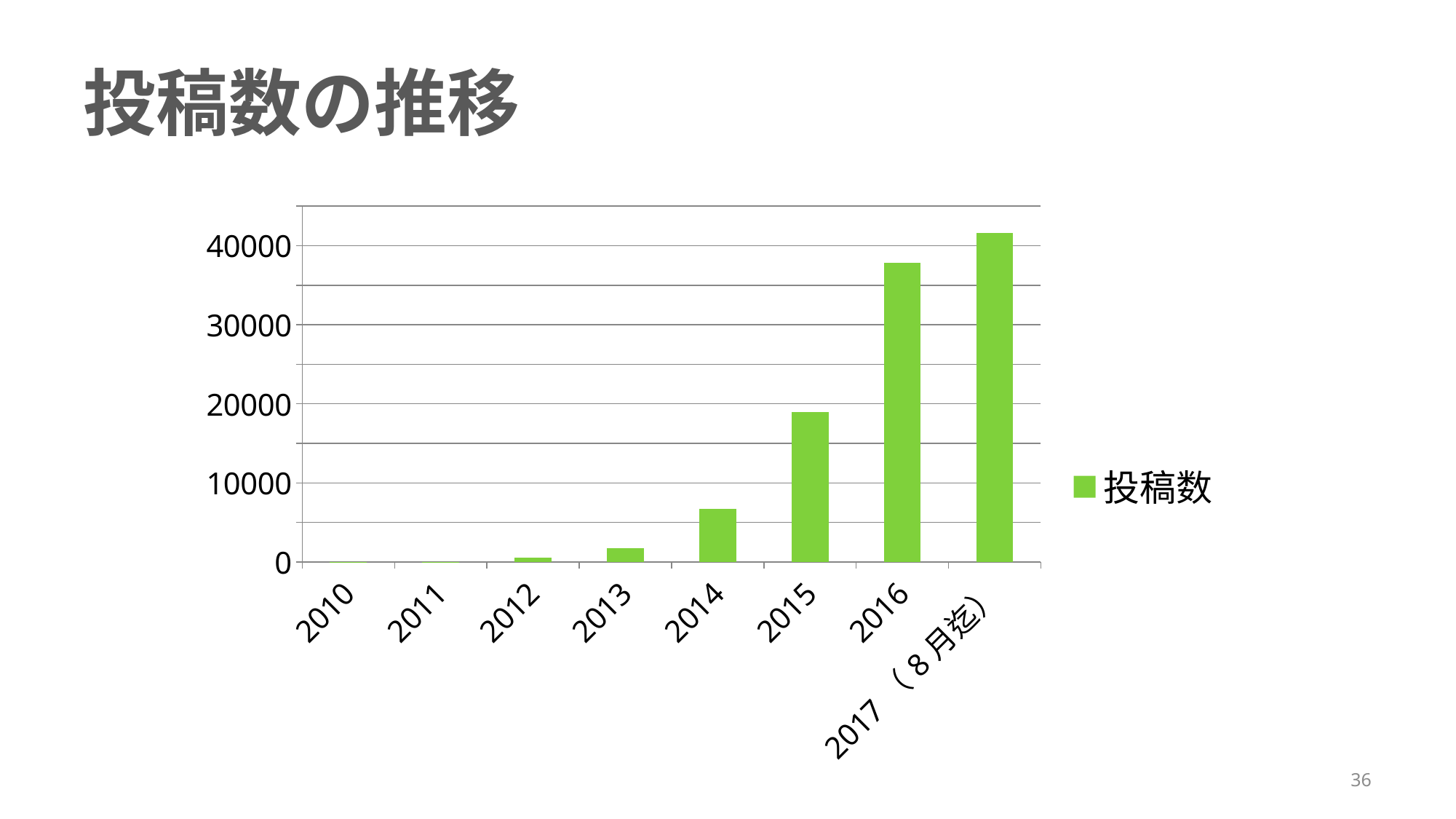
How many series does the legend list? 1 Which is larger, the value for 2013 or the value for 2014? 2014 What series name is shown in the chart legend? 投稿数 Is the value for 2015 greater or less than 20000? less Do the values generally rise or fall from 2010 to 2017（8月迄）? rise Is the value for 2016 greater or less than 30000? greater How many categories are shown on the x axis of the chart? 8 Is the value for 2014 greater or less than 10000? less Which is larger, the value for 2015 or the value for 2016? 2016 Which category has the highest value in the chart? 2017（8月迄） What kind of chart is shown on the slide? bar chart What is the title of the slide containing the chart? 投稿数の推移